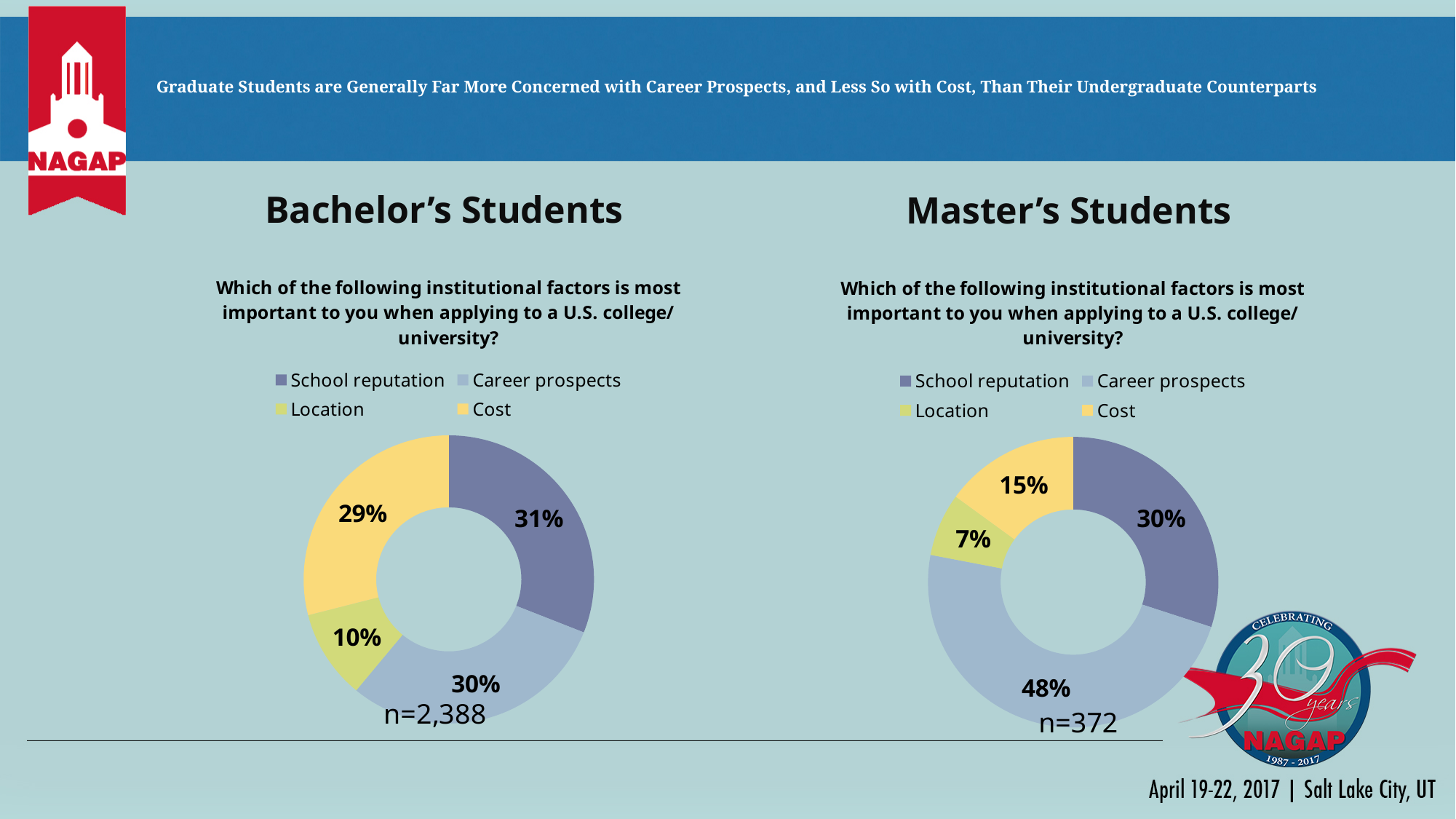
In the Master's Students chart, what percentage is shown for Career prospects? 48% What kind of chart is used for the Bachelor's Students data? Pie chart (donut) In the Bachelor's Students chart, what percentage is shown for Cost? 29% What is the difference between the Cost percentages in the Bachelor's Students chart and the Master's Students chart? 14% In the Bachelor's Students chart, what percentage is shown for Location? 10% In the Master's Students chart, which factor has the smallest share? Location In the Bachelor's Students chart, which is larger: School reputation or Cost? School reputation In the Bachelor's Students chart, which factor has the smallest share? Location How many categories does the legend list in the Master's Students chart? 4 In the Master's Students chart, which factor has the largest share? Career prospects In the Master's Students chart, what percentage is shown for Cost? 15% What is the sample size (n) shown under the Master's Students chart? n=372